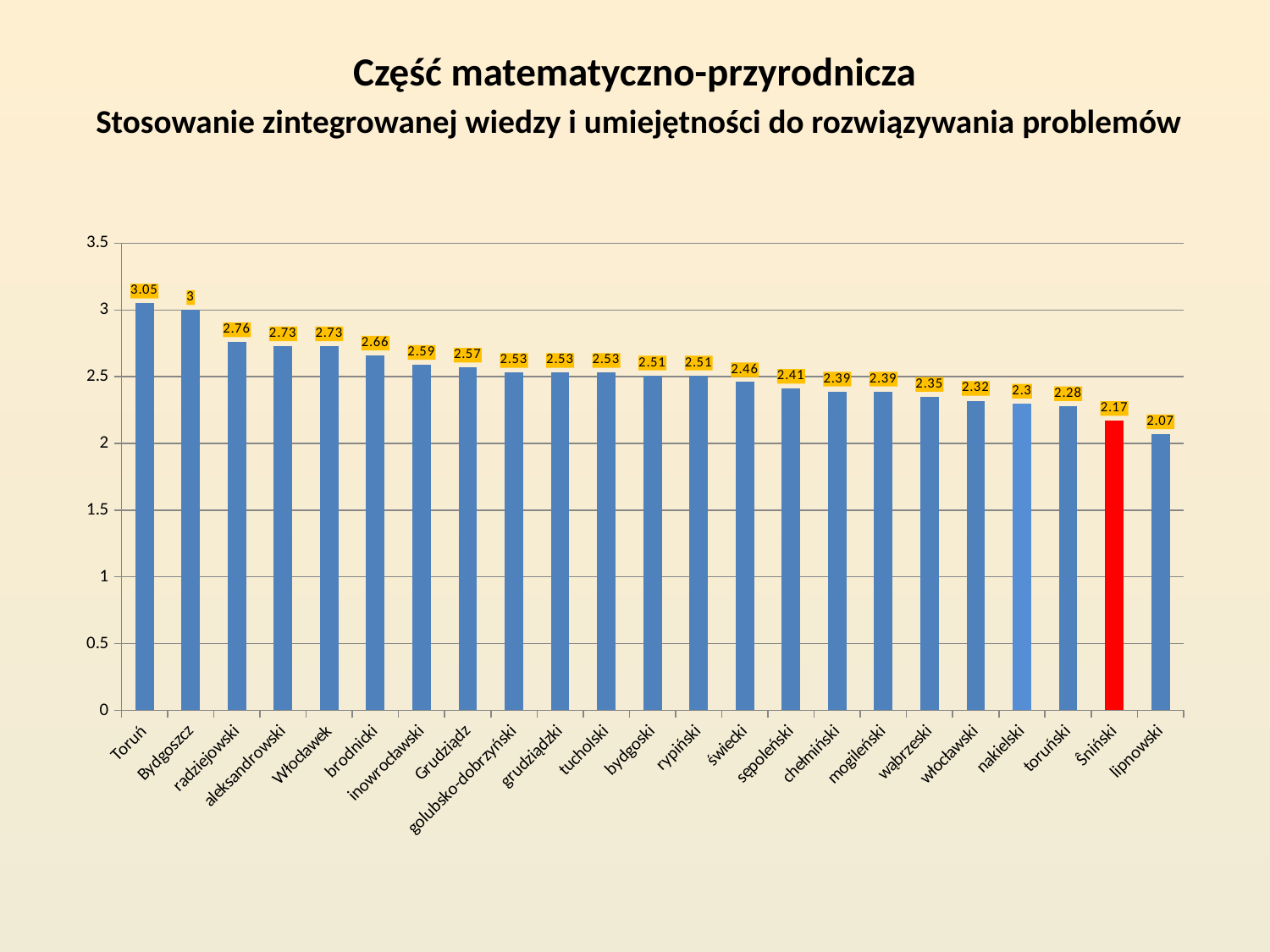
What is the value for Toruń? 3.05 Which category has the lowest value? lipnowski What is the difference between the values for Bydgoszcz and żniński? 0.83 What is the value for żniński? 2.17 What is the value for brodnicki? 2.66 Which bar is coloured red? żniński How many categories are shown on the x axis? 23 What kind of chart is shown on the slide? bar chart Which is larger, the value for radziejowski or the value for świecki? radziejowski Which category has the highest value? Toruń What is the value for nakielski? 2.3 What is the difference between the values for Toruń and lipnowski? 0.98